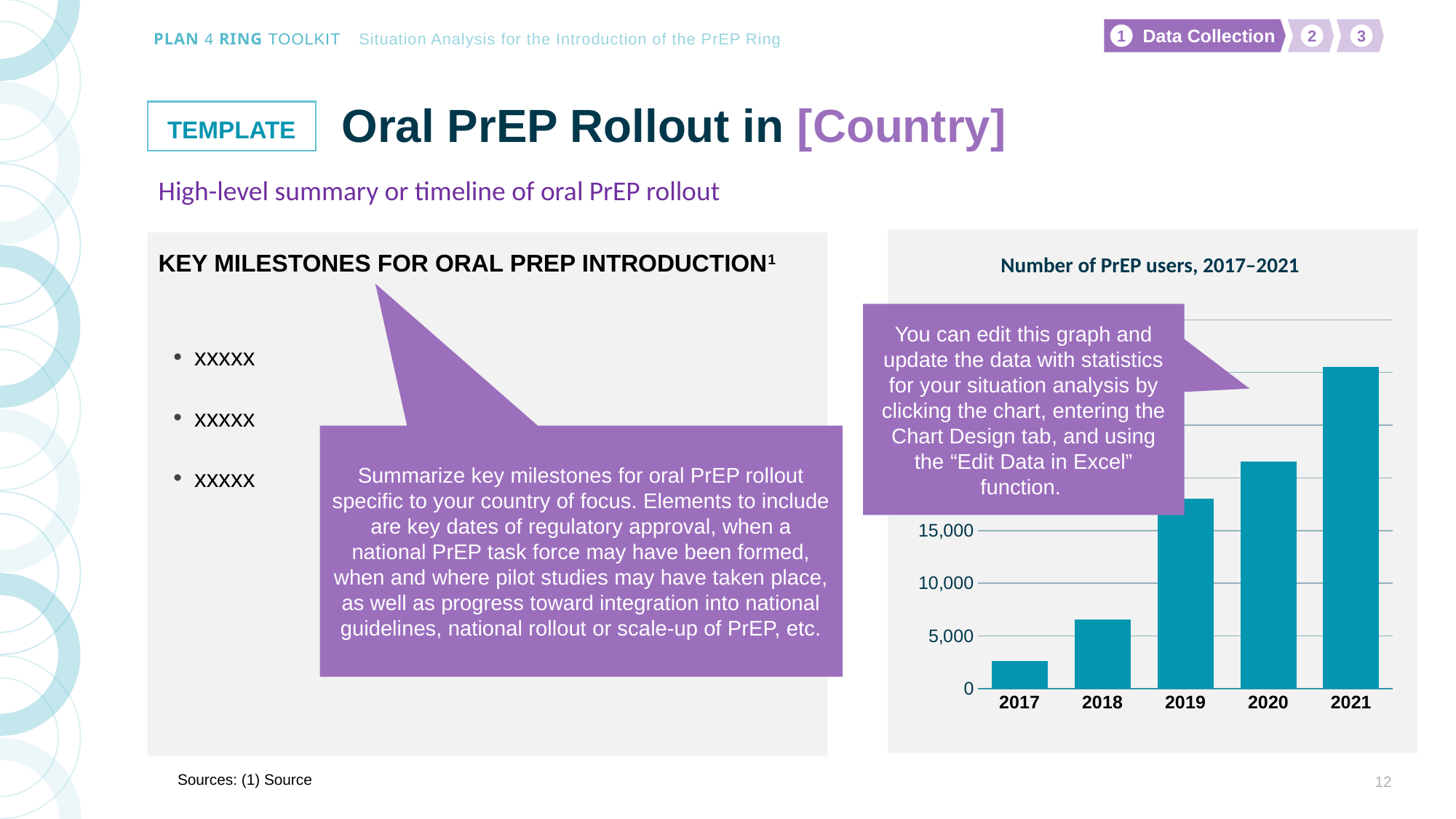
Which year has the lowest number of PrEP users in the chart? 2017 Which year has more PrEP users, 2018 or 2020? 2020 Is the value for 2017 greater or less than 5,000? less What is the title of the chart on the slide? Number of PrEP users, 2017–2021 What kind of chart is shown on the slide? bar chart Is the value for 2018 greater or less than 10,000? less Which year has more PrEP users, 2019 or 2021? 2021 Is the value for 2019 greater or less than 15,000? greater Do the number of PrEP users rise or fall from 2017 to 2021? rise How many years are plotted on the x axis of the chart? 5 Which year has the highest number of PrEP users in the chart? 2021